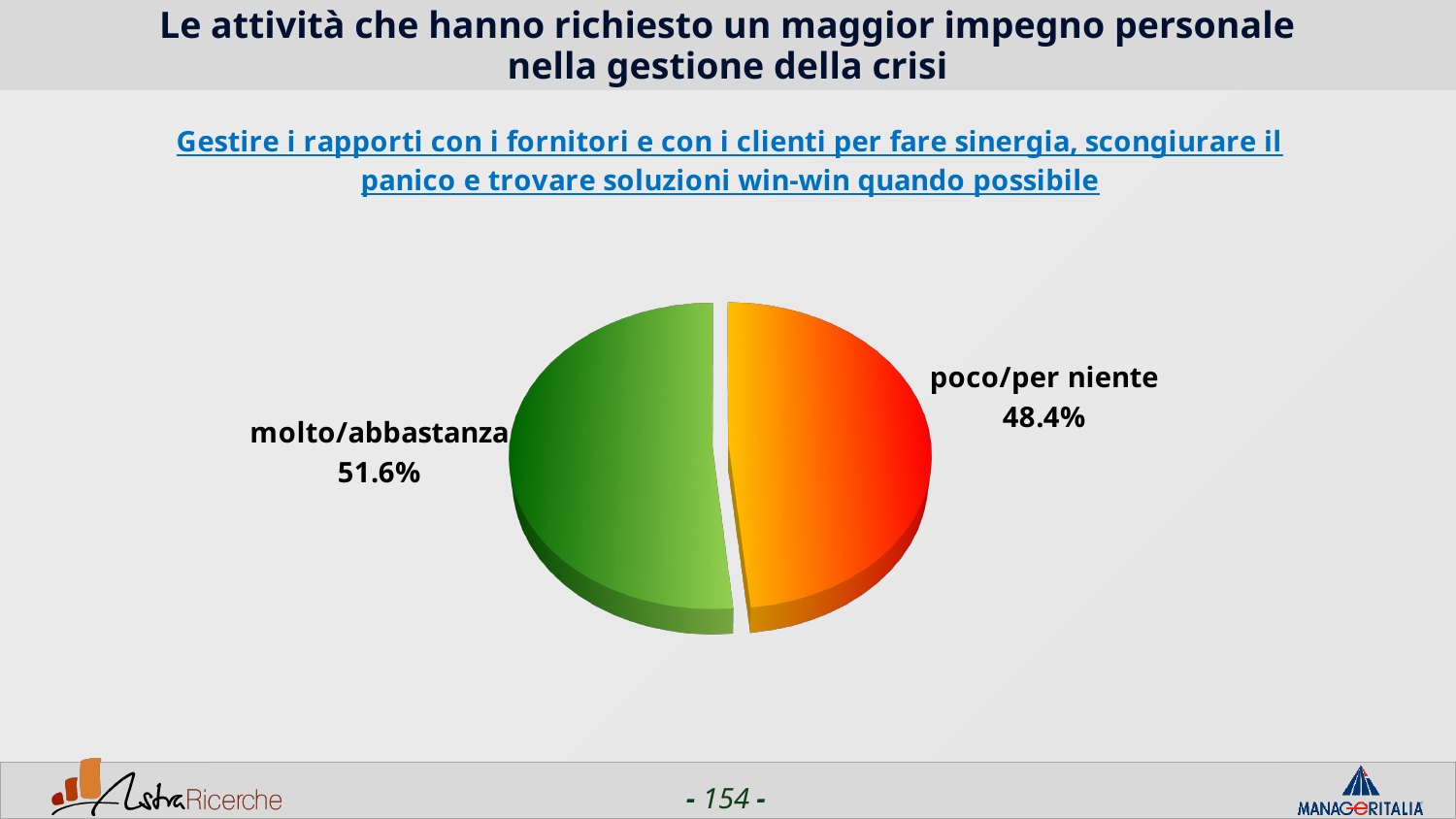
How many slices does the pie chart have? 2 Which slice of the pie is the largest? molto/abbastanza What percentage of respondents answered "molto/abbastanza"? 51.6% What colour is the "poco/per niente" slice? red/orange What is the difference in percentage points between "molto/abbastanza" and "poco/per niente"? 3.2 What colour is the "molto/abbastanza" slice? green What share of the pie does the "poco/per niente" slice represent? 48.4% What kind of chart is shown on the slide? pie chart Which is larger, the share for "molto/abbastanza" or for "poco/per niente"? molto/abbastanza What percentage of respondents answered "poco/per niente"? 48.4% Which slice of the pie is the smallest? poco/per niente